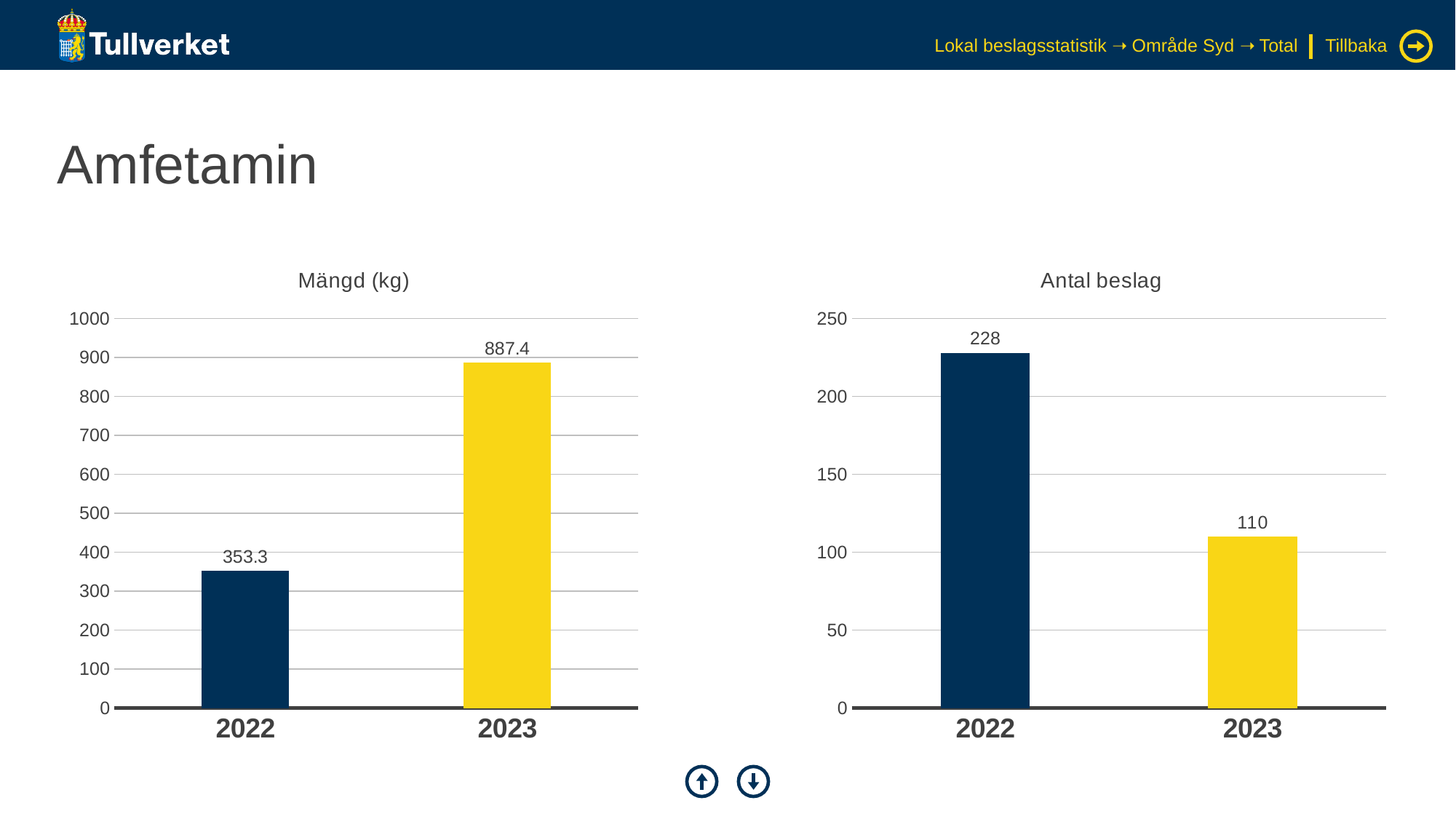
In the 'Mängd (kg)' chart, what is the difference between the 2023 and 2022 values? 534.1 In the 'Mängd (kg)' chart, is the value for 2023 greater or less than 800? greater In the 'Mängd (kg)' chart, what is the value for 2023? 887.4 In the 'Antal beslag' chart, what is the value for 2022? 228 In the 'Antal beslag' chart, what is the value for 2023? 110 How many categories are shown on the x axis of the 'Antal beslag' chart? 2 In the 'Antal beslag' chart, which year has the lowest value? 2023 In the 'Mängd (kg)' chart, what is the value for 2022? 353.3 What kind of chart is the 'Mängd (kg)' chart? bar chart In the 'Antal beslag' chart, what is the difference between the 2022 and 2023 values? 118 In the 'Antal beslag' chart, which is larger, the value for 2022 or 2023? 2022 In the 'Mängd (kg)' chart, which year has the highest value? 2023